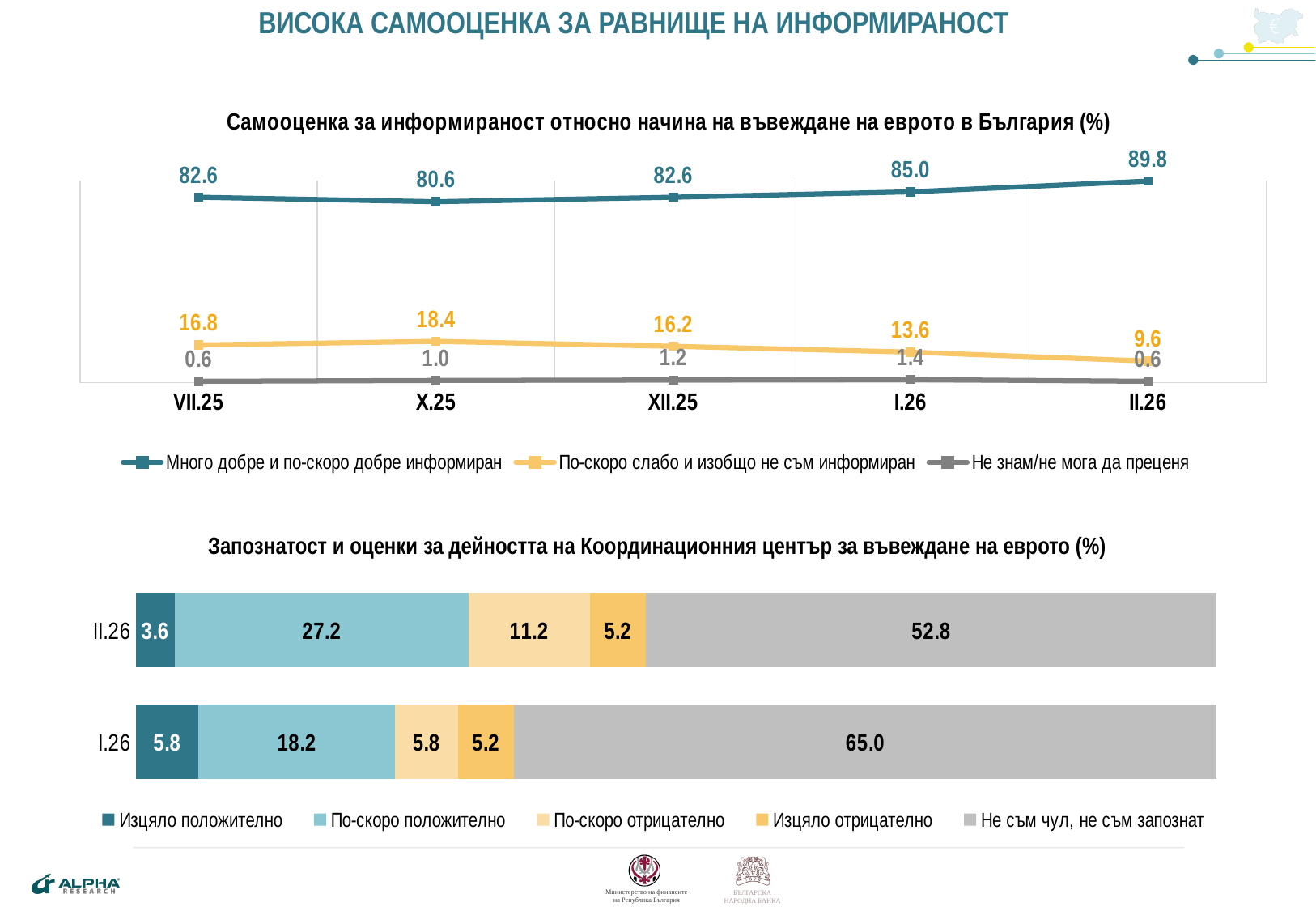
In the top chart, what is the value for 'По-скоро слабо и изобщо не съм информиран' at X.25? 18.4 In the top chart, at which time point is the 'Много добре и по-скоро добре информиран' series lowest? X.25 In the bottom chart, what is the value for 'По-скоро положително' for II.26? 27.2 In the top chart, what is the difference between the 'Много добре и по-скоро добре информиран' value at II.26 and at VII.25? 7.2 In the bottom chart, which is larger: 'По-скоро отрицателно' for II.26 or for I.26? II.26 In the top chart (Самооценка за информираност относно начина на въвеждане на еврото в България), what is the value for 'Много добре и по-скоро добре информиран' at II.26? 89.8 In the bottom chart (Запознатост и оценки за дейността на Координационния център за въвеждане на еврото), what is the value for 'Не съм чул, не съм запознат' for I.26? 65.0 What kind of chart is the bottom chart on the slide? stacked bar chart In the top chart, does the 'По-скоро слабо и изобщо не съм информиран' series rise or fall from X.25 to II.26? fall In the bottom chart, what is the total of the II.26 stacked bar? 100.0 What kind of chart is the top chart on the slide? line chart How many series does the legend of the top chart list? 3